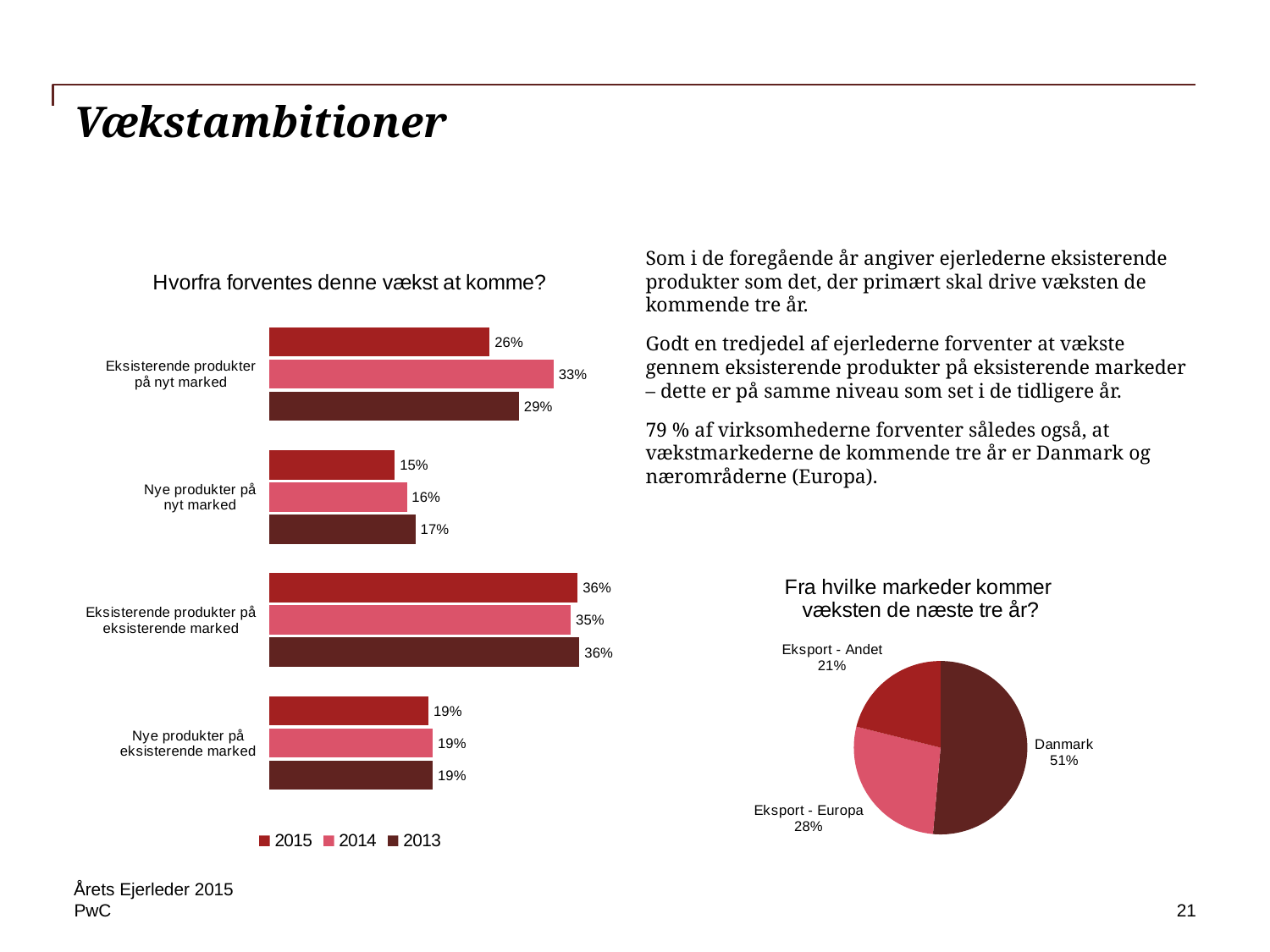
In the chart 'Hvorfra forventes denne vækst at komme?', what is the value for 'Eksisterende produkter på nyt marked' in 2014? 33% In the chart 'Hvorfra forventes denne vækst at komme?', which is larger for 2013: 'Eksisterende produkter på nyt marked' or 'Nye produkter på eksisterende marked'? Eksisterende produkter på nyt marked What kind of chart is 'Hvorfra forventes denne vækst at komme?'? Bar chart In the chart 'Hvorfra forventes denne vækst at komme?', what is the difference between the 2014 and 2015 values for 'Eksisterende produkter på nyt marked'? 7% In the chart 'Hvorfra forventes denne vækst at komme?', how many series does the legend list? 3 In the chart 'Hvorfra forventes denne vækst at komme?', which category has the lowest value for 2014? Nye produkter på nyt marked In the chart 'Hvorfra forventes denne vækst at komme?', what is the value for 'Nye produkter på nyt marked' in 2013? 17% In the pie chart 'Fra hvilke markeder kommer væksten de næste tre år?', what share does 'Eksport - Europa' have? 28% In the chart 'Hvorfra forventes denne vækst at komme?', how many categories are shown? 4 In the chart 'Hvorfra forventes denne vækst at komme?', which category has the highest value for 2015? Eksisterende produkter på eksisterende marked What kind of chart is 'Fra hvilke markeder kommer væksten de næste tre år?'? Pie chart In the pie chart 'Fra hvilke markeder kommer væksten de næste tre år?', which slice is the largest? Danmark